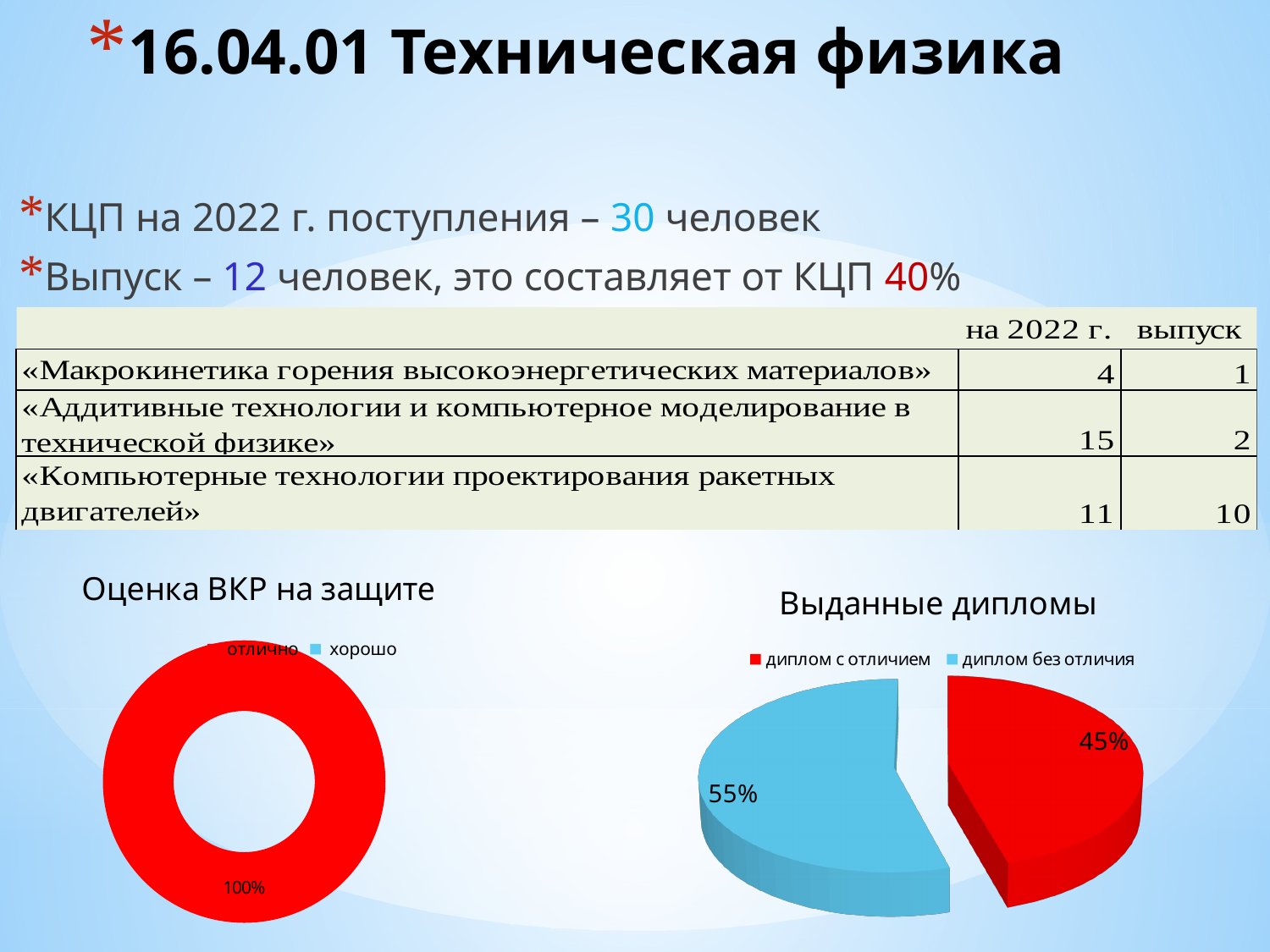
In the chart titled «Выданные дипломы», which category has the smaller share? диплом с отличием What kind of chart is the chart titled «Выданные дипломы»? pie chart In the chart titled «Выданные дипломы», is the share for «диплом с отличием» larger or smaller than the share for «диплом без отличия»? smaller In the chart titled «Оценка ВКР на защите», what share is labelled for «отлично»? 100% In the chart titled «Выданные дипломы», what share is shown for «диплом без отличия»? 55% How many entries does the legend of the chart titled «Оценка ВКР на защите» list? 2 What kind of chart is the chart titled «Оценка ВКР на защите»? doughnut chart In the chart titled «Выданные дипломы», what colour is the slice for «диплом без отличия»? light blue How many entries does the legend of the chart titled «Выданные дипломы» list? 2 In the chart titled «Выданные дипломы», what share is shown for «диплом с отличием»? 45% In the chart titled «Выданные дипломы», what is the difference in percentage points between «диплом без отличия» and «диплом с отличием»? 10% In the chart titled «Выданные дипломы», which category has the larger share? диплом без отличия